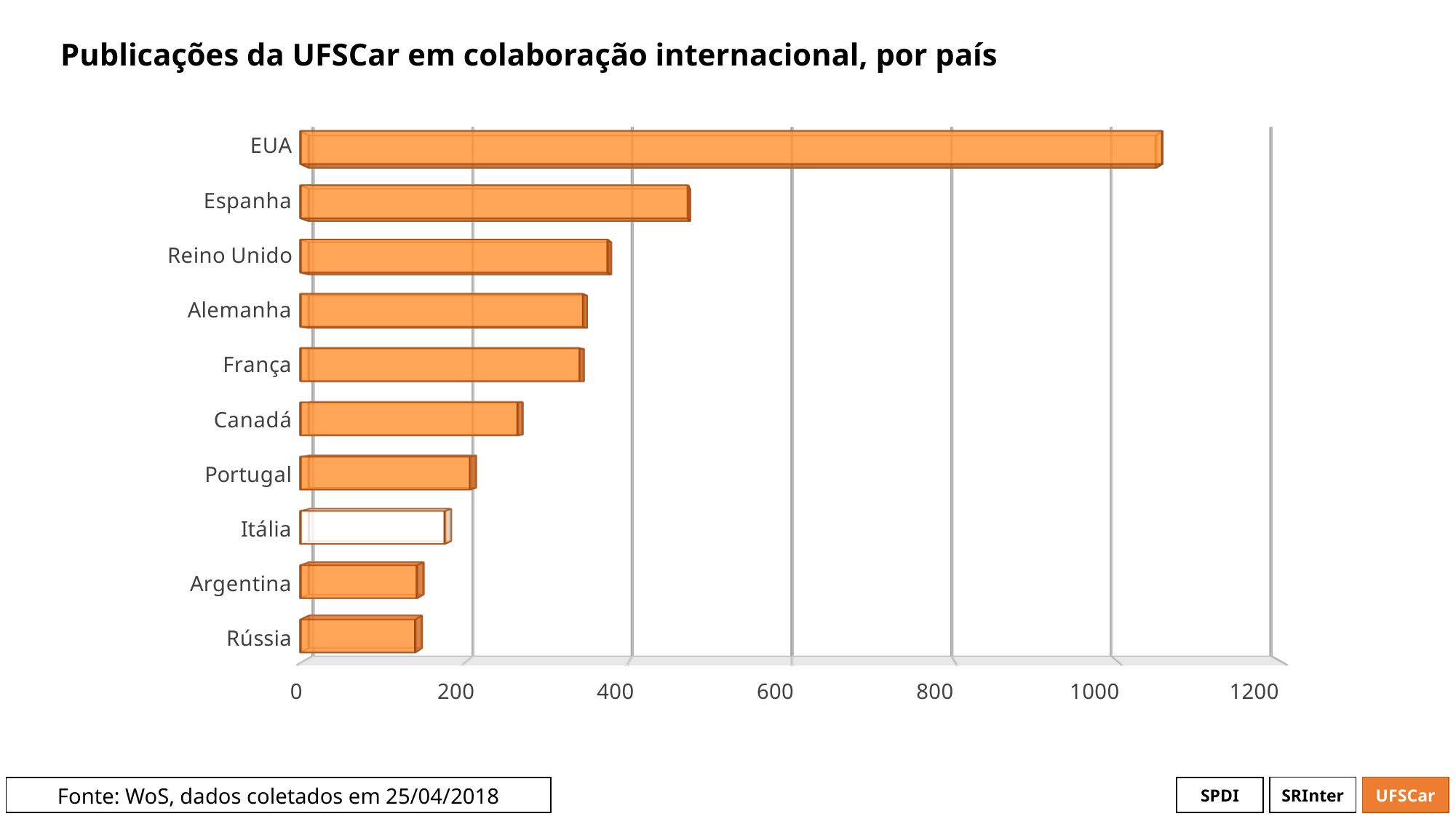
What is the title of the chart? Publicações da UFSCar em colaboração internacional, por país Which country's bar is drawn with a white fill instead of orange? Itália Which country has the highest number of publications in international collaboration? EUA Is the value for Reino Unido greater or less than 400? less What kind of chart is shown on the slide? bar chart Which has a larger value, EUA or Espanha? EUA Is the value for Canadá greater or less than 200? greater How many countries are shown in the chart? 10 Is the value for Rússia greater or less than 200? less Which has a larger value, Canadá or Portugal? Canadá